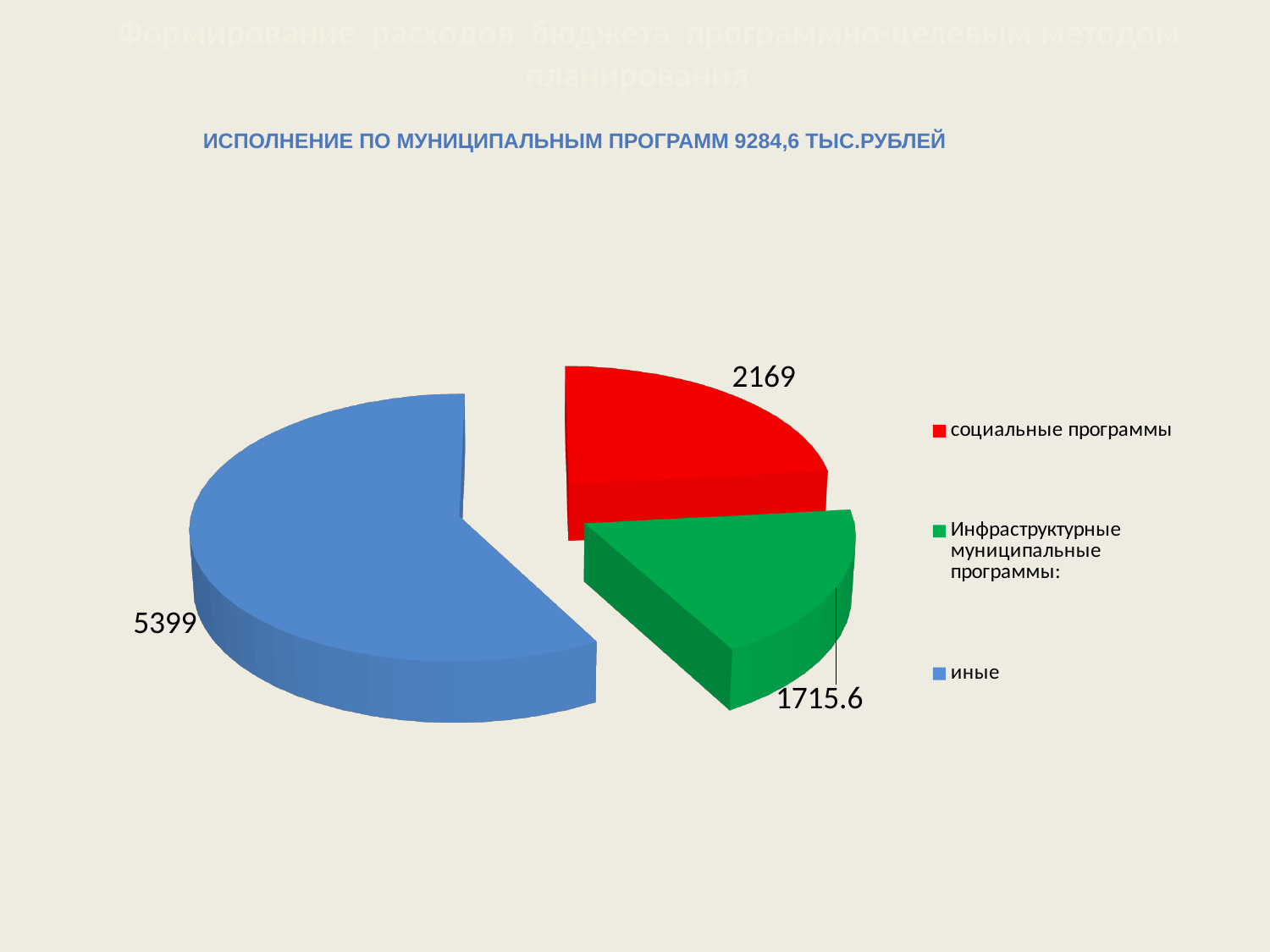
What is the value for социальные программы? 2169 What is the value for Инфраструктурные муниципальные программы? 1715.6 What is the difference between the values for иные and социальные программы? 3230 Which category has the smallest slice of the pie? Инфраструктурные муниципальные программы How many slices does the pie chart have? 3 Which is larger, the value for социальные программы or the value for Инфраструктурные муниципальные программы? социальные программы What is the difference between the values for социальные программы and Инфраструктурные муниципальные программы? 453.4 What type of chart is shown on the slide? pie chart Which category has the largest slice of the pie? иные What total amount is stated in the chart title? 9284,6 тыс.рублей What is the value for иные? 5399 What colour is the slice for иные? blue